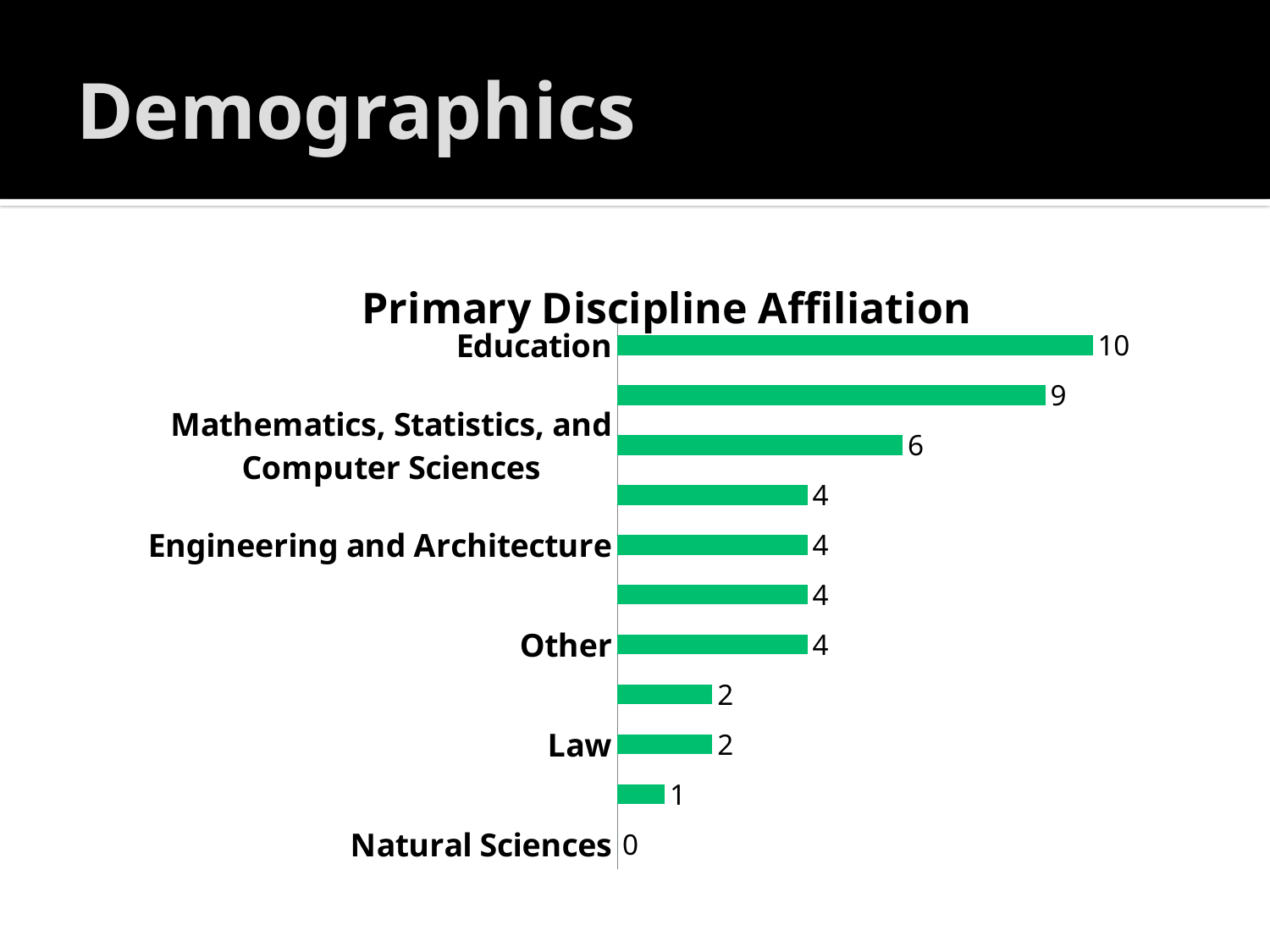
What is the value for Education in the Primary Discipline Affiliation chart? 10 What is the difference between the values for Education and Mathematics, Statistics, and Computer Sciences? 4 What is the value for Mathematics, Statistics, and Computer Sciences? 6 How many bars are plotted in the chart? 11 Which has a larger value, Education or Law? Education What is the value for Natural Sciences? 0 What is the value for Other? 4 Which discipline has the highest value in the chart? Education What type of chart is shown on the slide? Bar chart What is the value for Engineering and Architecture? 4 Which discipline has the lowest value in the chart? Natural Sciences What is the value for Law? 2